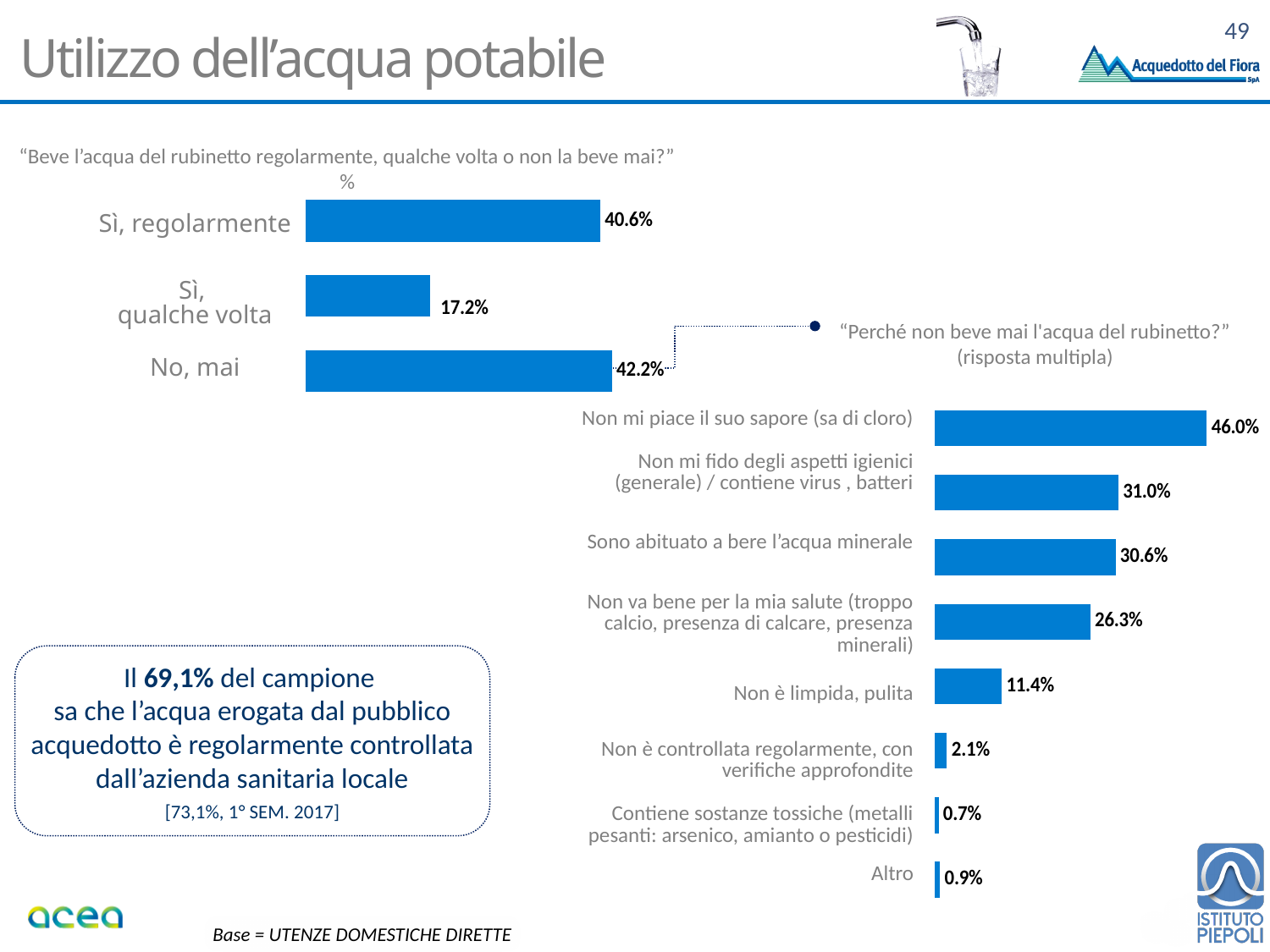
In the chart 'Beve l'acqua del rubinetto regolarmente, qualche volta o non la beve mai?', what is the difference between 'No, mai' and 'Sì, regolarmente'? 1.6% In the chart 'Perché non beve mai l'acqua del rubinetto?', how many categories are shown? 8 In the chart 'Perché non beve mai l'acqua del rubinetto?', what is the value for 'Non mi piace il suo sapore (sa di cloro)'? 46.0% In the chart 'Beve l'acqua del rubinetto regolarmente, qualche volta o non la beve mai?', what is the value for 'Sì, qualche volta'? 17.2% In the chart 'Beve l'acqua del rubinetto regolarmente, qualche volta o non la beve mai?', what is the value for 'Sì, regolarmente'? 40.6% In the chart 'Perché non beve mai l'acqua del rubinetto?', which is larger: 'Sono abituato a bere l'acqua minerale' or 'Non va bene per la mia salute'? Sono abituato a bere l'acqua minerale In the chart 'Perché non beve mai l'acqua del rubinetto?', what is the value for 'Non è limpida, pulita'? 11.4% In the chart 'Perché non beve mai l'acqua del rubinetto?', which category has the lowest value? Contiene sostanze tossiche (metalli pesanti: arsenico, amianto o pesticidi) In the chart 'Beve l'acqua del rubinetto regolarmente, qualche volta o non la beve mai?', how many categories are shown? 3 In the chart 'Perché non beve mai l'acqua del rubinetto?', which category has the highest value? Non mi piace il suo sapore (sa di cloro) In the chart 'Beve l'acqua del rubinetto regolarmente, qualche volta o non la beve mai?', which category has the lowest value? Sì, qualche volta What kind of chart is 'Perché non beve mai l'acqua del rubinetto?'? Bar chart